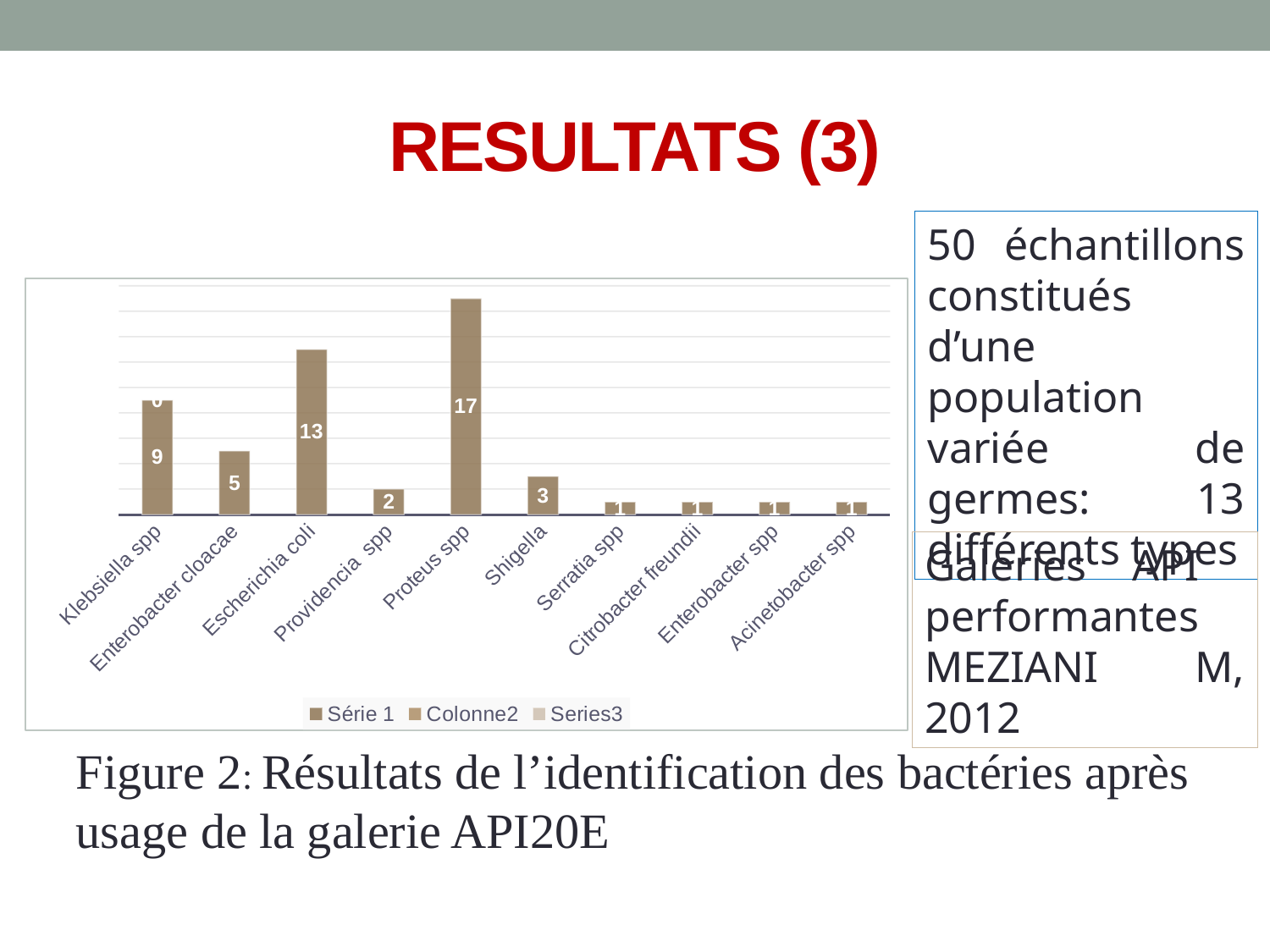
What is the value for Proteus spp? 17 Which is larger, the value for Klebsiella spp or the value for Enterobacter cloacae? Klebsiella spp What is the value for Providencia spp? 2 What is the value for Enterobacter cloacae? 5 How many series does the legend list? 3 What is the value for Shigella? 3 What type of chart is shown on the slide? bar chart Which category has the highest value? Proteus spp What is the value for Escherichia coli? 13 What is the value for Klebsiella spp? 9 How many categories are shown on the x axis? 10 What is the difference between the values for Proteus spp and Escherichia coli? 4